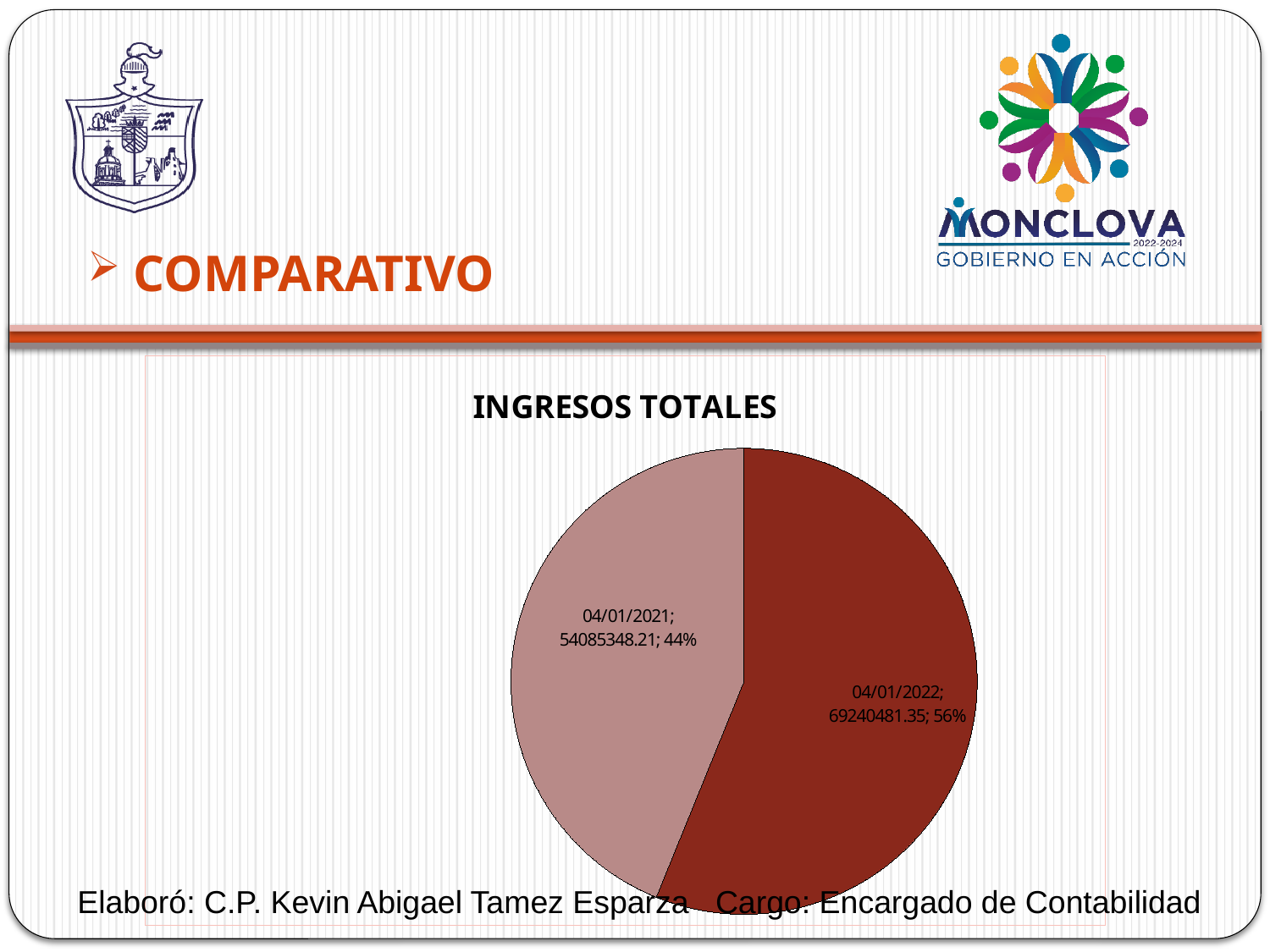
Which is larger, the value for 04/01/2021 or 04/01/2022? 04/01/2022 Which slice is the largest? 04/01/2022 What is the total of the two values shown in the pie chart? 123325829.56 Which slice is the smallest? 04/01/2021 How many slices does the pie chart have? 2 What share of the pie does 04/01/2021 represent? 44% What kind of chart is shown on the slide? pie chart What is the value for 04/01/2021? 54085348.21 What is the title of the chart? INGRESOS TOTALES What is the difference between the values for 04/01/2022 and 04/01/2021? 15155133.14 What share of the pie does 04/01/2022 represent? 56% What is the value for 04/01/2022? 69240481.35